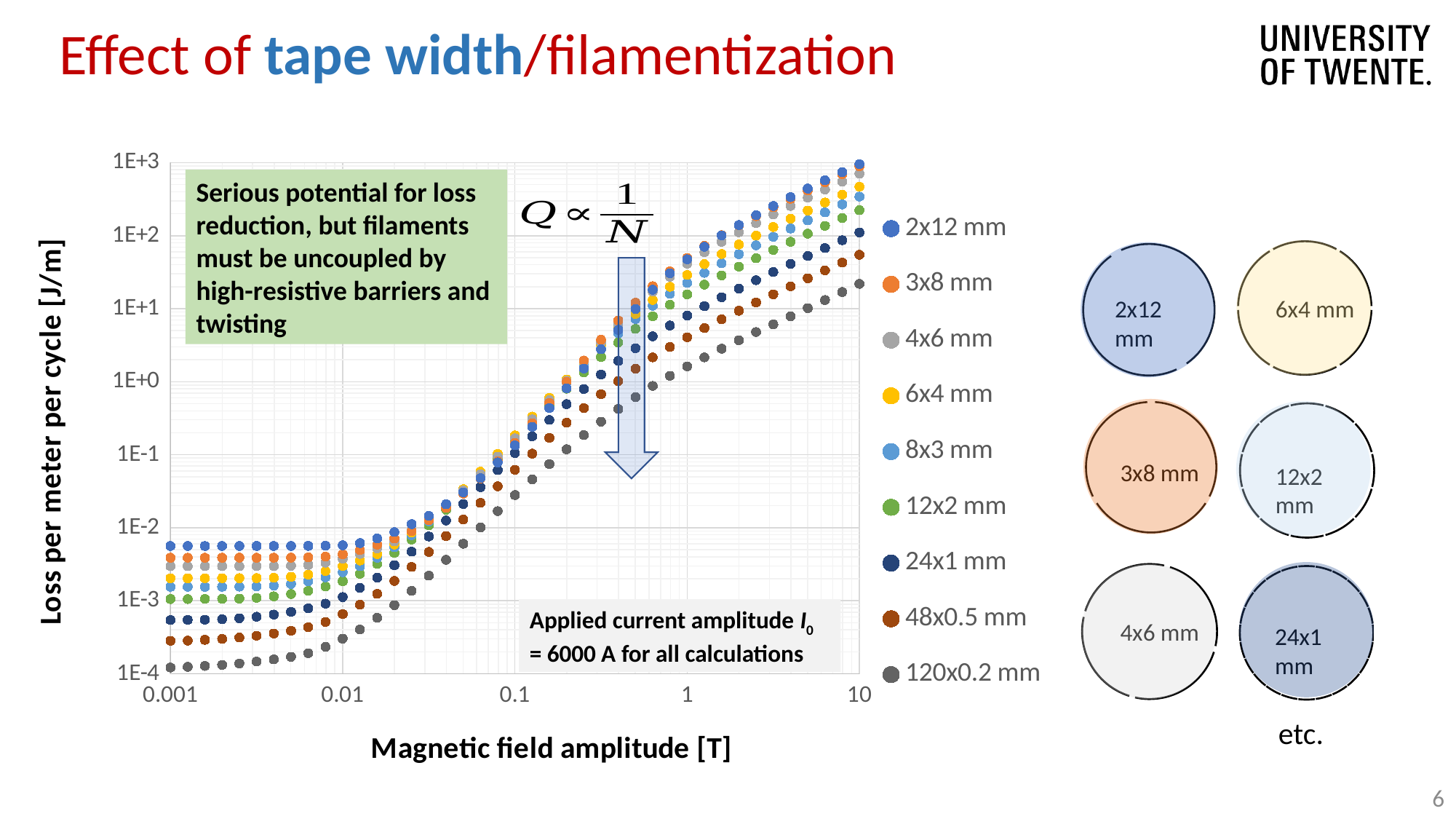
What is the label of the x axis of the chart? Magnetic field amplitude [T] At a magnetic field amplitude of 1 T, which series has the larger loss: 2x12 mm or 120x0.2 mm? 2x12 mm Which series has the lowest loss per meter per cycle across the plotted field range? 120x0.2 mm Is the loss for the 2x12 mm series at 0.001 T greater or less than 1E-3 J/m? greater How many series does the chart legend list? 9 Which series has the highest loss per meter per cycle at a magnetic field amplitude of 0.001 T? 2x12 mm Is the loss for the 2x12 mm series at 0.001 T greater or less than 1E-2 J/m? less Do the loss values rise or fall as the magnetic field amplitude increases along the x axis? rise What kind of chart is shown on the slide? scatter chart Is the loss for the 24x1 mm series at 0.001 T greater or less than 1E-3 J/m? less What is the label of the y axis of the chart? Loss per meter per cycle [J/m]